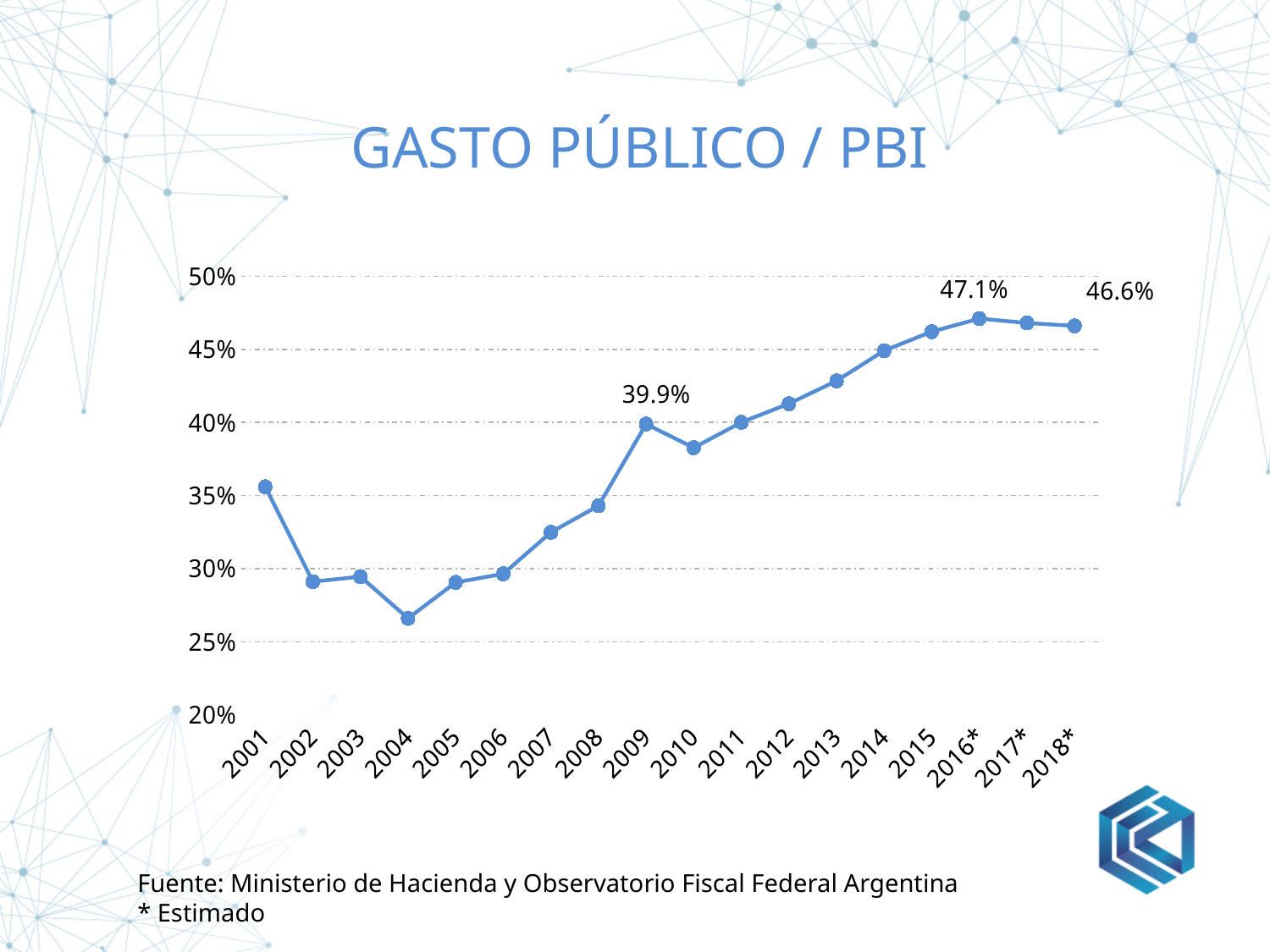
What kind of chart is shown? line chart What is the difference between the values for 2016* and 2018*? 0.5 percentage points Is the value for 2010 greater or less than 40%? less What is the value for 2009? 39.9% Which year has the lowest value? 2004 What is the value for 2018*? 46.6% Which is larger, the value for 2001 or the value for 2002? 2001 Is the value for 2001 greater or less than 35%? greater How many years are plotted on the chart? 18 Is the value for 2004 greater or less than 30%? less What is the difference between the values for 2016* and 2009? 7.2 percentage points What is the value for 2016*? 47.1%